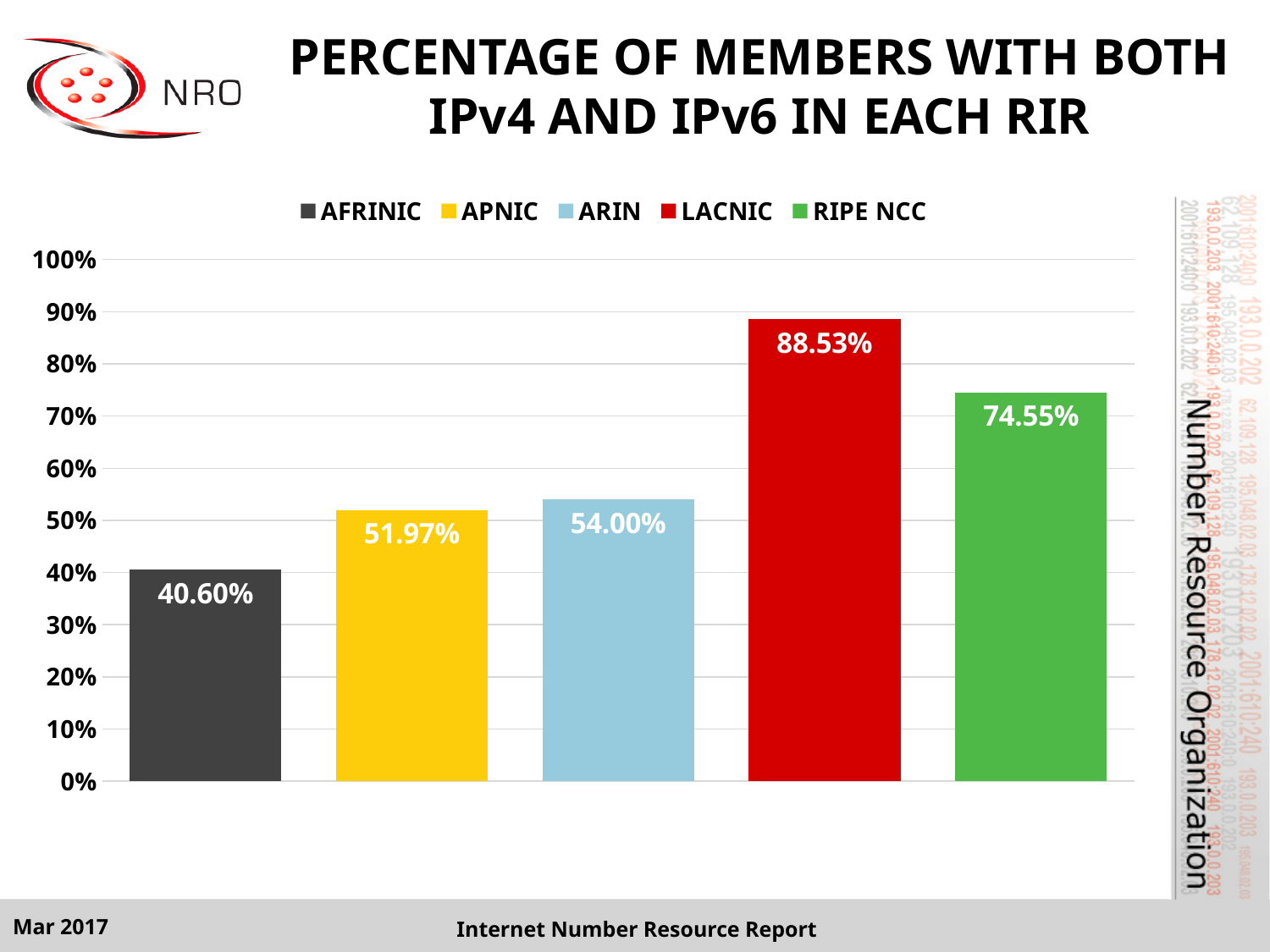
What is the value shown for RIPE NCC? 74.55% What is the percentage of members with both IPv4 and IPv6 for LACNIC? 88.53% How many RIRs are shown in the chart? 5 What is the difference between the LACNIC and RIPE NCC percentages? 13.98% What is the difference between the ARIN and APNIC percentages? 2.03% What colour is the bar for LACNIC? Red What is the percentage of members with both IPv4 and IPv6 for AFRINIC? 40.60% What kind of chart is shown on the slide? Bar chart Which RIR has the highest percentage of members with both IPv4 and IPv6? LACNIC Which has a higher percentage, APNIC or ARIN? ARIN Is the value for RIPE NCC greater or less than 70%? greater Which RIR has the lowest percentage of members with both IPv4 and IPv6? AFRINIC